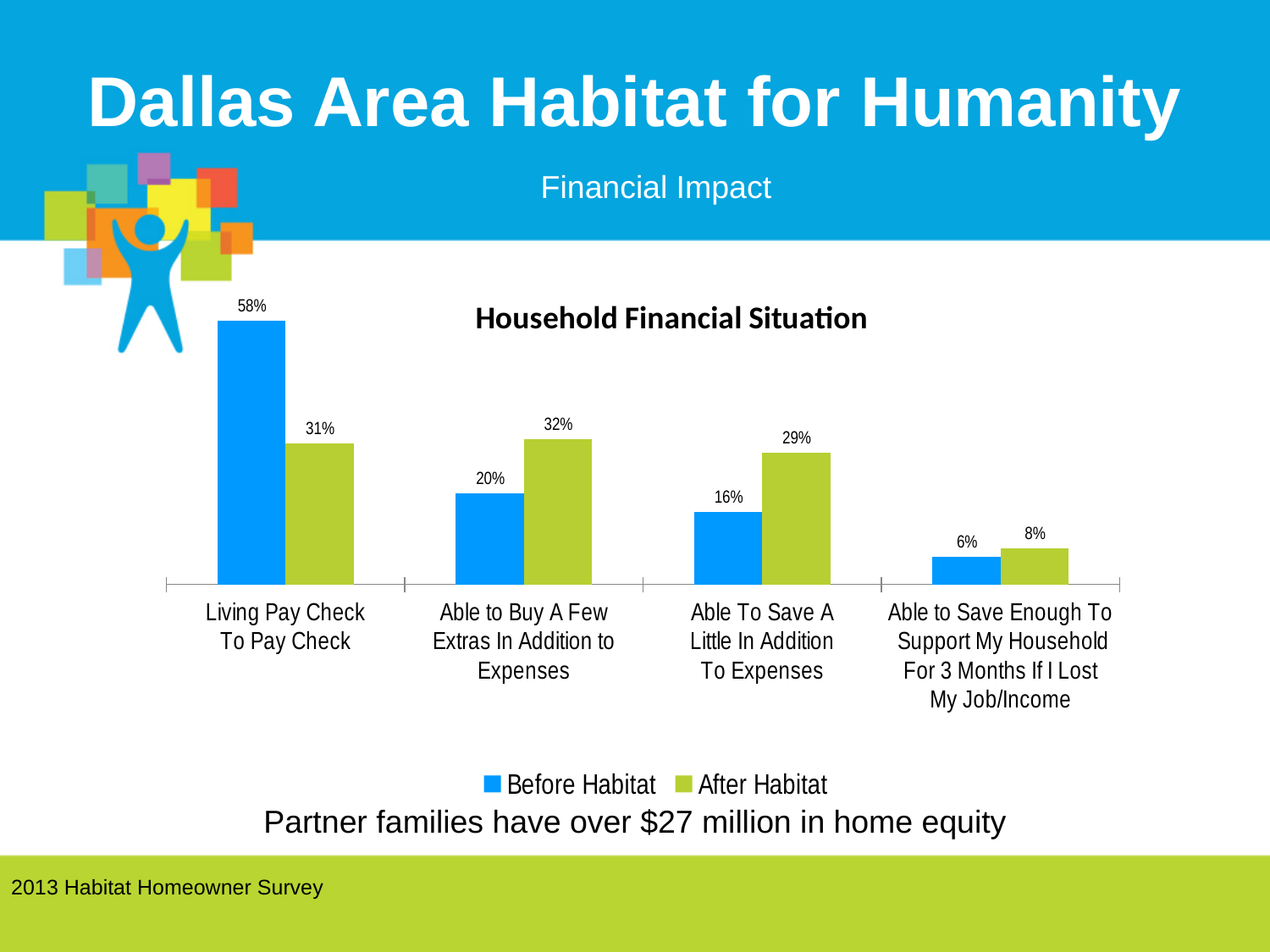
Which category has the highest Before Habitat value? Living Pay Check To Pay Check What is the title of the chart? Household Financial Situation What is the difference between the After Habitat and Before Habitat values for "Able To Save A Little In Addition To Expenses"? 13% What is the difference between the Before Habitat and After Habitat values for "Living Pay Check To Pay Check"? 27% What is the After Habitat value for "Able to Save Enough To Support My Household For 3 Months If I Lost My Job/Income"? 8% How many categories are shown on the x axis of the chart? 4 Which category has the lowest After Habitat value? Able to Save Enough To Support My Household For 3 Months If I Lost My Job/Income How many series does the legend list? 2 What is the Before Habitat value for "Living Pay Check To Pay Check"? 58% For "Able to Buy A Few Extras In Addition to Expenses", which is larger: the Before Habitat value or the After Habitat value? After Habitat What is the After Habitat value for "Able To Save A Little In Addition To Expenses"? 29% What kind of chart is shown on the slide? Bar chart